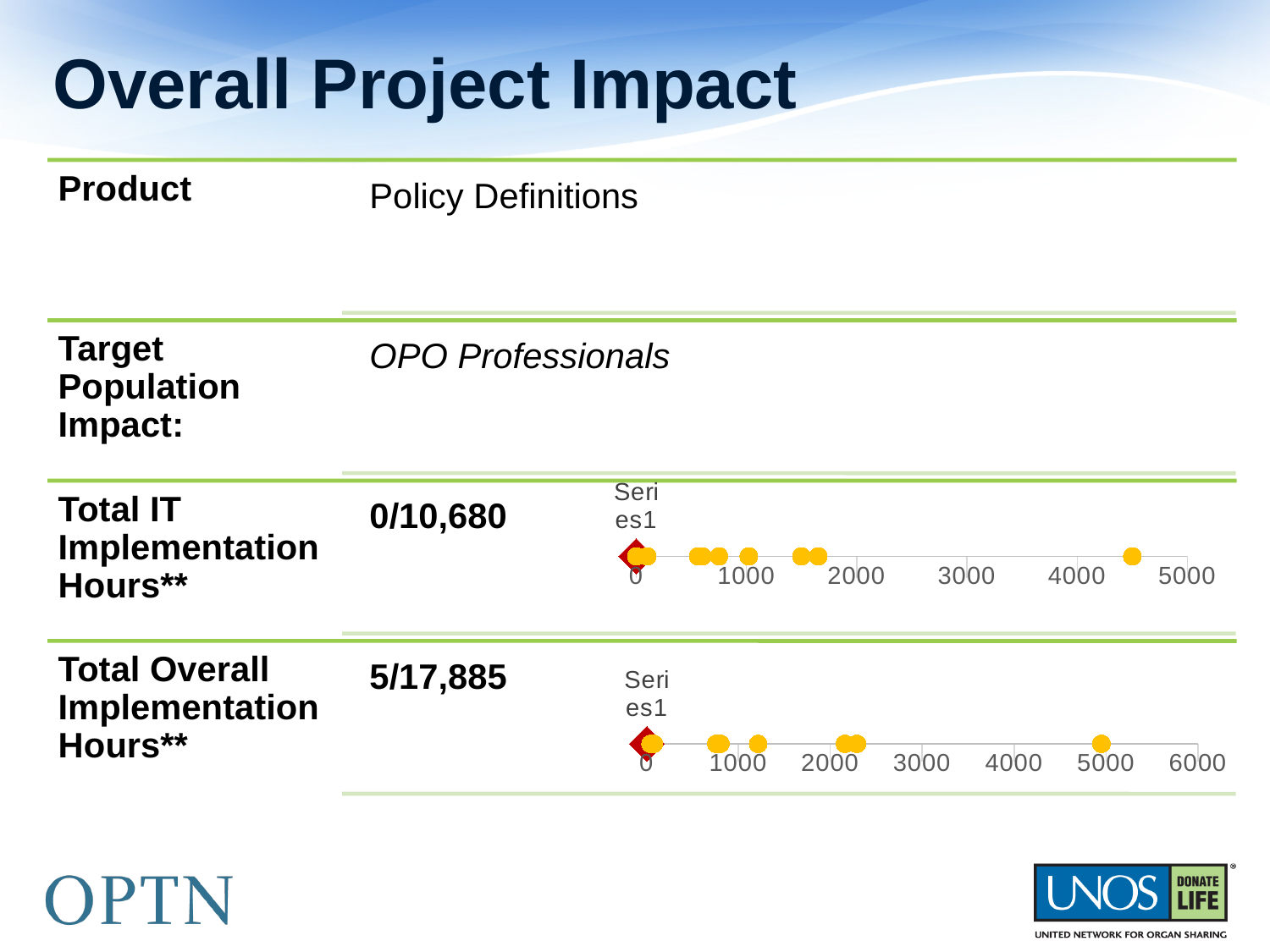
In the chart next to "Total Overall Implementation Hours**", is the rightmost point greater or less than 4000? greater In the chart next to "Total Overall Implementation Hours**", is the rightmost point greater or less than 6000? less In the chart next to "Total IT Implementation Hours**", is the rightmost point greater or less than 4000? greater In the chart next to "Total Overall Implementation Hours**", what is the highest tick label on the axis? 6000 What kind of chart is shown next to "Total IT Implementation Hours**"? scatter chart In the chart next to "Total IT Implementation Hours**", what is the highest tick label on the axis? 5000 What kind of chart is shown next to "Total Overall Implementation Hours**"? scatter chart